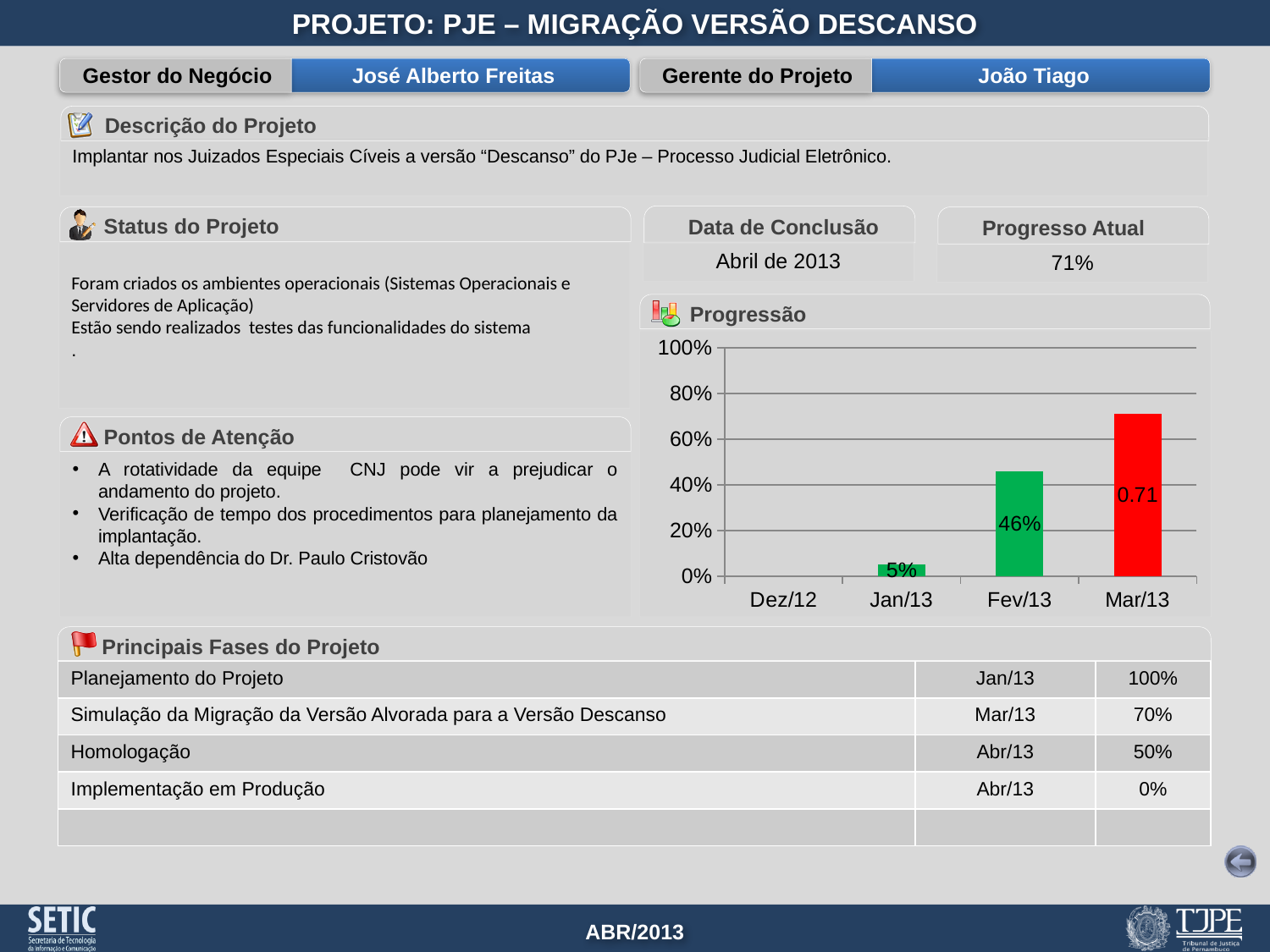
How many months are shown on the x axis of the Progressão chart? 4 Which month has the highest bar in the Progressão chart? Mar/13 Which is larger in the Progressão chart, the value for Jan/13 or the value for Fev/13? Fev/13 Is the value for Mar/13 in the Progressão chart greater or less than 60%? greater Do the values in the Progressão chart rise or fall from Jan/13 to Mar/13? rise What is the value for Jan/13 in the Progressão chart? 5% What is the value for Fev/13 in the Progressão chart? 46% What kind of chart is the Progressão chart? bar chart Is the value for Fev/13 in the Progressão chart greater or less than 60%? less What data label is shown on the Mar/13 bar in the Progressão chart? 0.71 What colour is the Mar/13 bar in the Progressão chart? red What is the difference between the Fev/13 and Jan/13 values in the Progressão chart? 41%